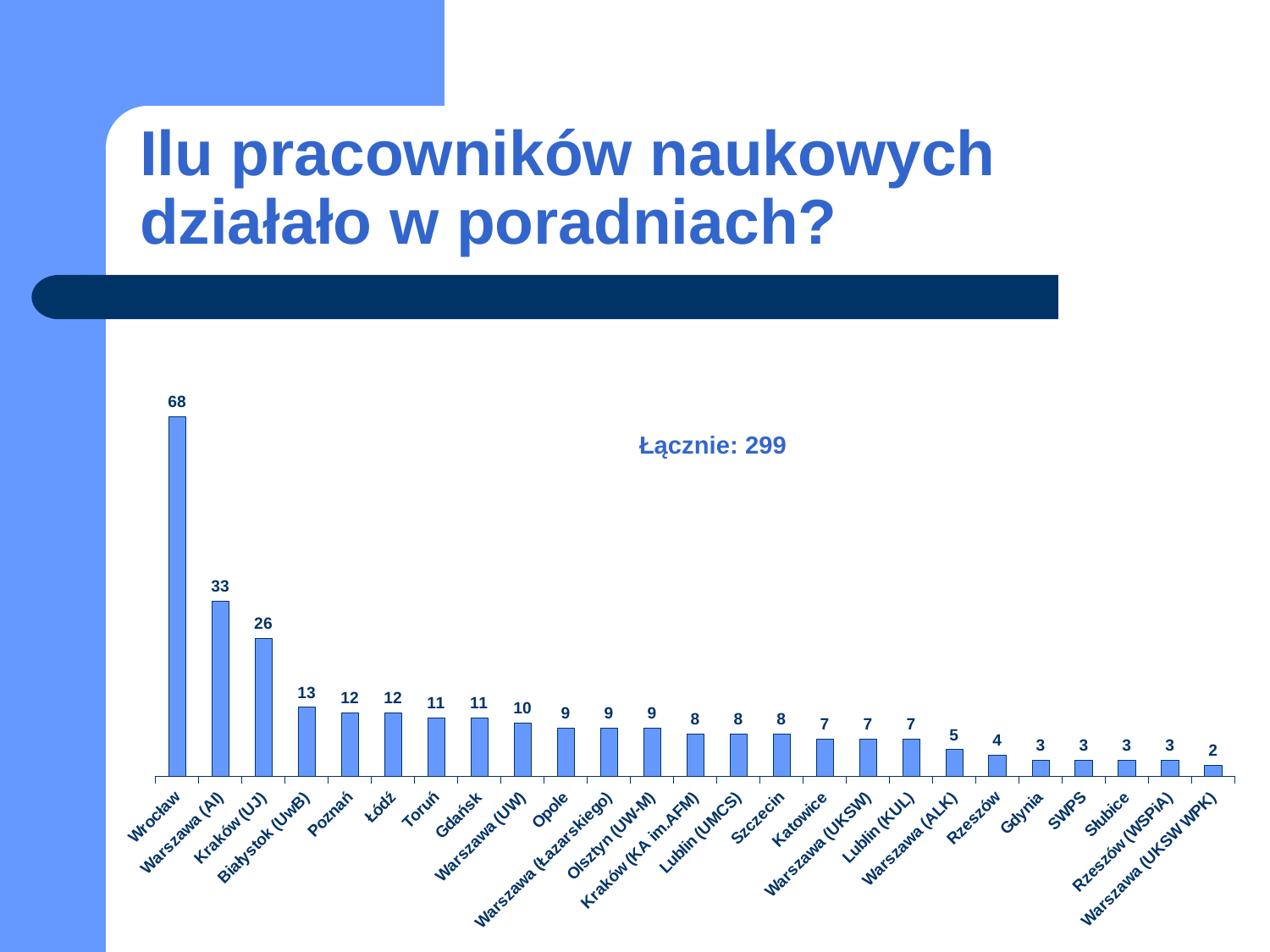
Which category has the lowest value? Warszawa (UKSW WPK) Do the values rise or fall from left to right along the x axis? Fall What total (Łącznie) is printed on the chart? 299 What is the value for Warszawa (ALK)? 5 What kind of chart is shown on the slide? Bar chart What is the value for Kraków (UJ)? 26 What is the value for Białystok (UwB)? 13 Which is larger, the value for Toruń or the value for Rzeszów? Toruń Which category has the highest value? Wrocław What is the value for Wrocław? 68 What is the difference between the values for Wrocław and Warszawa (AI)? 35 How many categories are shown on the x axis? 25